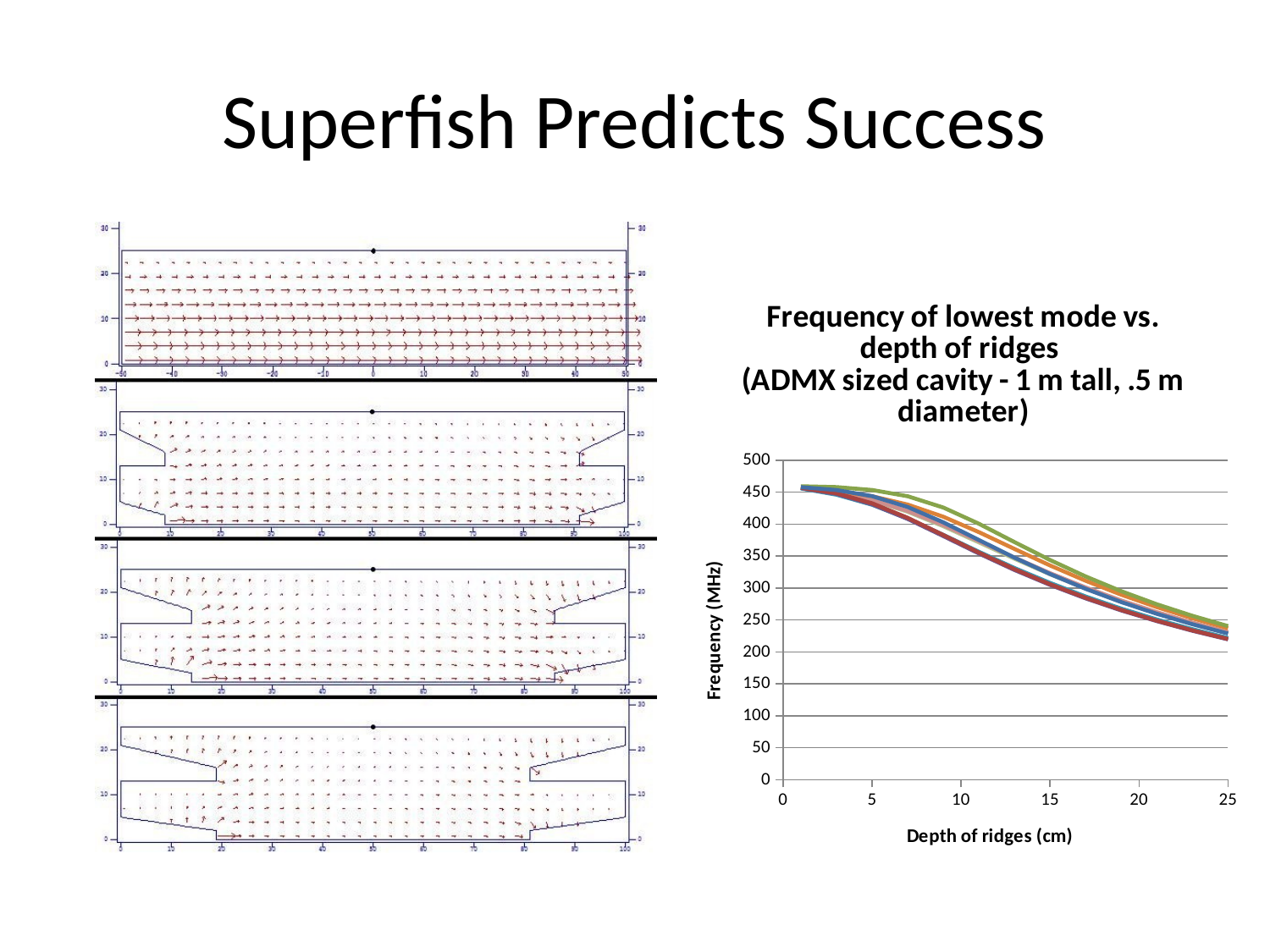
In the 'Frequency of lowest mode vs. depth of ridges' chart, is the frequency at a depth of 15 cm greater or less than 400 MHz? less In the 'Frequency of lowest mode vs. depth of ridges' chart, is the frequency higher at a depth of 5 cm or at a depth of 20 cm? 5 cm What is the label of the x axis on the 'Frequency of lowest mode vs. depth of ridges' chart? Depth of ridges (cm) In the 'Frequency of lowest mode vs. depth of ridges' chart, do the frequency values rise or fall as the depth of ridges increases? fall In the 'Frequency of lowest mode vs. depth of ridges' chart, is the frequency at a depth of 5 cm greater or less than 400 MHz? greater What kind of chart is the 'Frequency of lowest mode vs. depth of ridges' chart? line chart In the 'Frequency of lowest mode vs. depth of ridges' chart, is the frequency at a depth of 25 cm greater or less than 250 MHz? less What is the label of the y axis on the 'Frequency of lowest mode vs. depth of ridges' chart? Frequency (MHz)